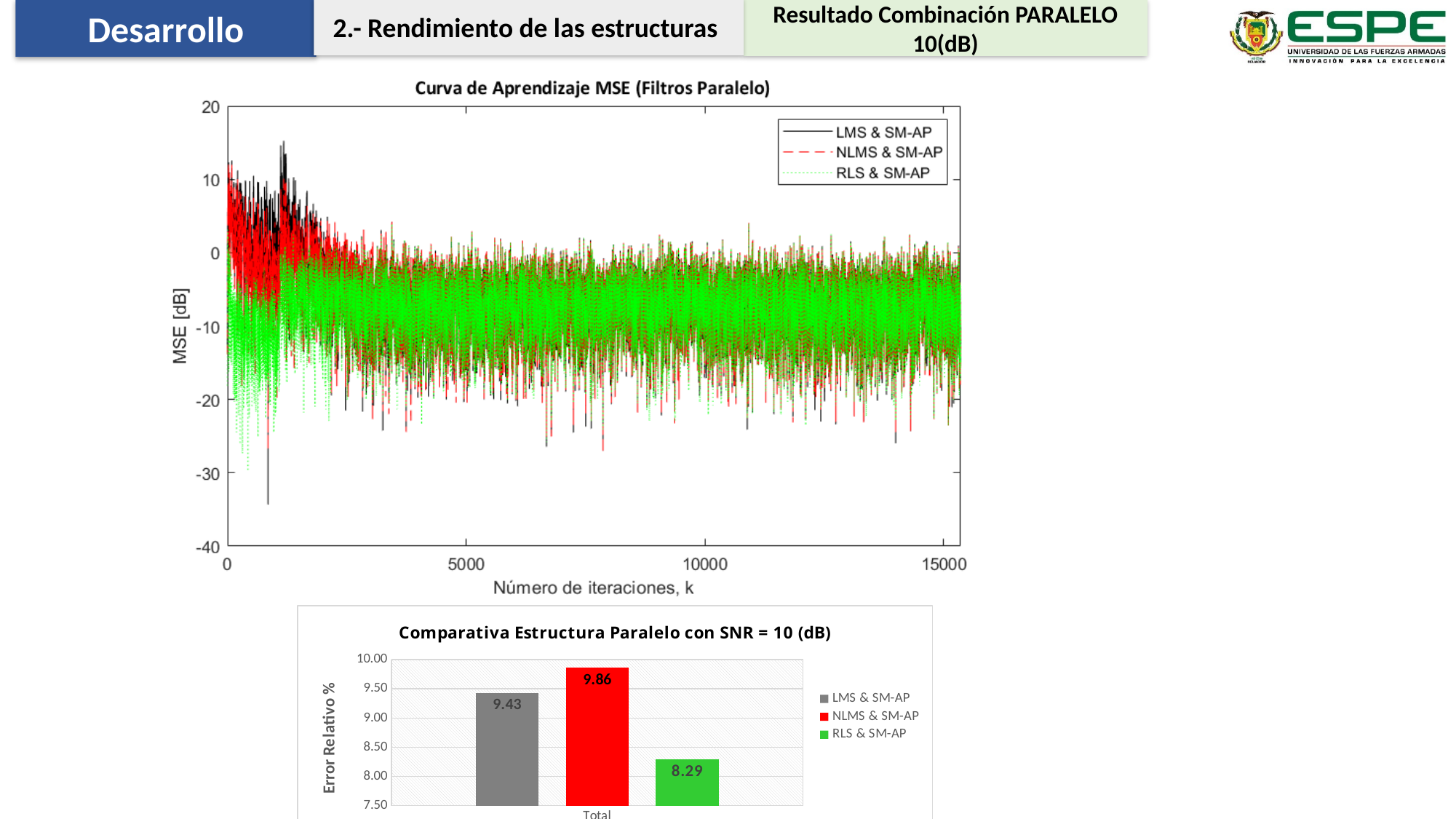
In the chart titled 'Comparativa Estructura Paralelo con SNR = 10 (dB)', what is the value for LMS & SM-AP? 9.43 In the chart titled 'Comparativa Estructura Paralelo con SNR = 10 (dB)', what is the difference between the NLMS & SM-AP value and the RLS & SM-AP value? 1.57 What kind of chart is the one titled 'Comparativa Estructura Paralelo con SNR = 10 (dB)'? Bar chart What kind of chart is the one titled 'Curva de Aprendizaje MSE (Filtros Paralelo)'? Line chart In the chart titled 'Comparativa Estructura Paralelo con SNR = 10 (dB)', what is the value for RLS & SM-AP? 8.29 In the chart titled 'Curva de Aprendizaje MSE (Filtros Paralelo)', how many series does the legend list? 3 In the chart titled 'Comparativa Estructura Paralelo con SNR = 10 (dB)', which is larger, the value for LMS & SM-AP or the value for RLS & SM-AP? LMS & SM-AP In the chart titled 'Comparativa Estructura Paralelo con SNR = 10 (dB)', which series has the lowest value? RLS & SM-AP In the chart titled 'Curva de Aprendizaje MSE (Filtros Paralelo)', what is the label of the x axis? Número de iteraciones, k In the chart titled 'Comparativa Estructura Paralelo con SNR = 10 (dB)', how many series does the legend list? 3 In the chart titled 'Comparativa Estructura Paralelo con SNR = 10 (dB)', which series has the highest value? NLMS & SM-AP In the chart titled 'Comparativa Estructura Paralelo con SNR = 10 (dB)', what is the value for NLMS & SM-AP? 9.86